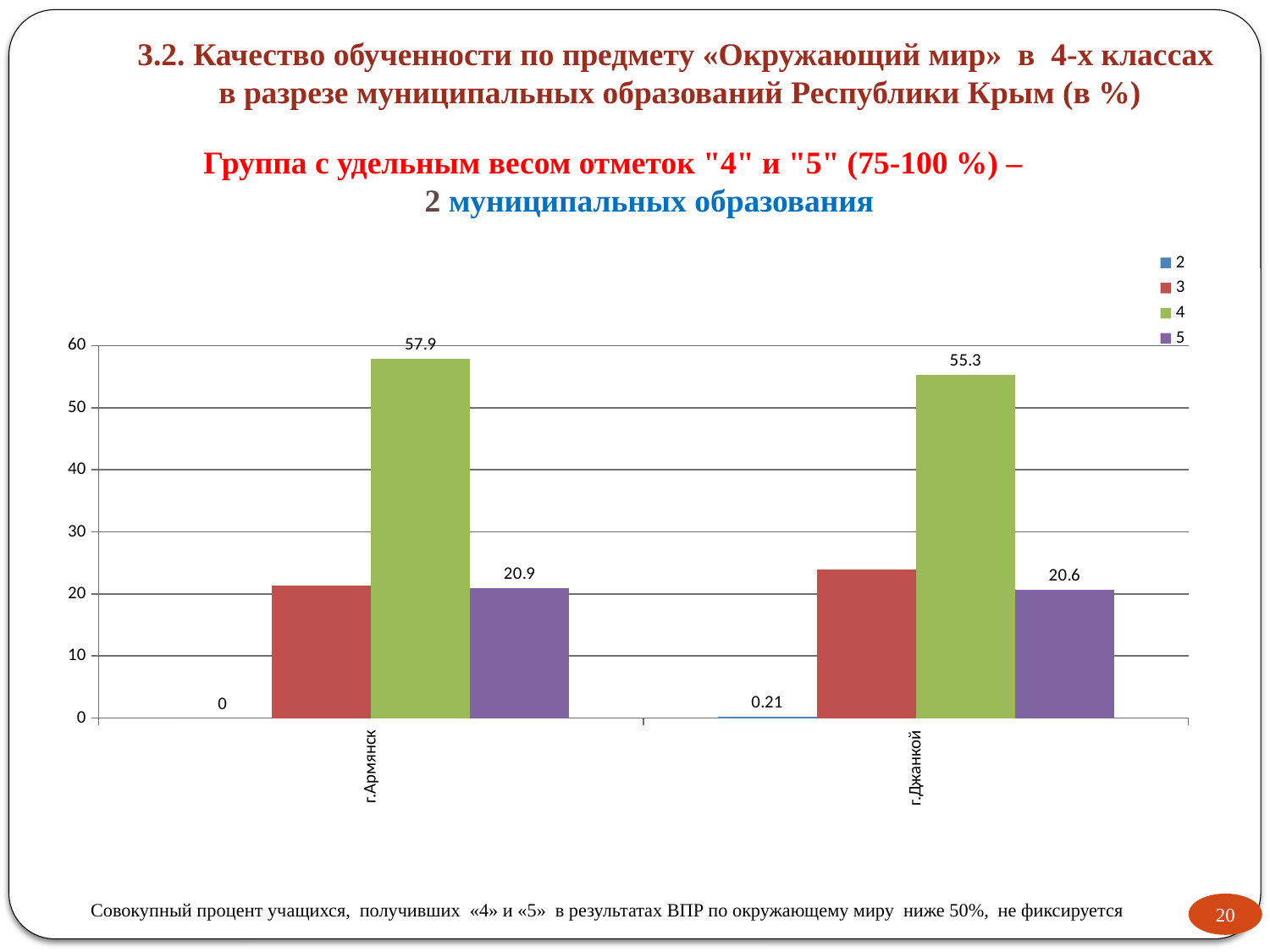
Which series has the highest value at г.Армянск? 4 How many series does the legend list? 4 What is the difference between the series 4 values for г.Армянск and г.Джанкой? 2.6 What is the value for series 2 at г.Джанкой? 0.21 What is the value for series 2 at г.Армянск? 0 Which municipality has the larger value for series 4, г.Армянск or г.Джанкой? г.Армянск How many municipalities (categories) are shown on the x axis? 2 What kind of chart is shown on the slide? bar chart What is the value for series 4 at г.Джанкой? 55.3 Is the value for series 3 at г.Джанкой greater or less than 20? greater What is the value for series 5 at г.Армянск? 20.9 What is the value for series 4 at г.Армянск? 57.9